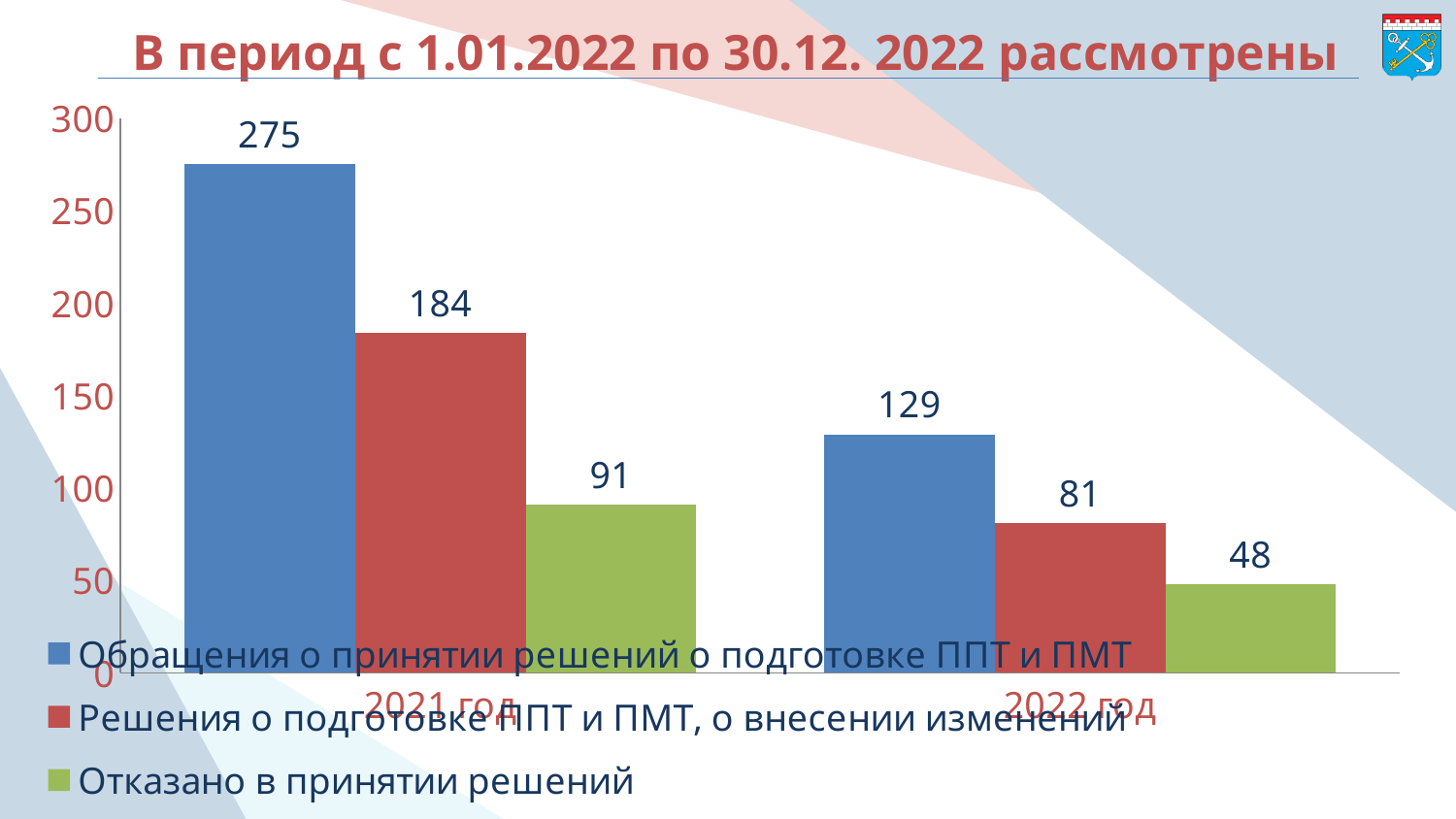
How many categories are shown on the x axis? 2 What is the value of 'Обращения о принятии решений о подготовке ППТ и ПМТ' for 2021 год? 275 Which series has the lowest value in 2022 год? Отказано в принятии решений What type of chart is shown on the slide? bar chart How many series does the legend list? 3 Do the values for 'Решения о подготовке ППТ и ПМТ, о внесении изменений' rise or fall from 2021 год to 2022 год? fall What is the difference between the 'Обращения о принятии решений о подготовке ППТ и ПМТ' values for 2021 год and 2022 год? 146 What is the value of 'Решения о подготовке ППТ и ПМТ, о внесении изменений' for 2022 год? 81 What is the value of 'Обращения о принятии решений о подготовке ППТ и ПМТ' for 2022 год? 129 Which is larger: 'Решения о подготовке ППТ и ПМТ, о внесении изменений' in 2021 год or 'Обращения о принятии решений о подготовке ППТ и ПМТ' in 2022 год? Решения о подготовке ППТ и ПМТ, о внесении изменений in 2021 год What is the value of 'Отказано в принятии решений' for 2021 год? 91 Which year has the highest value for 'Отказано в принятии решений'? 2021 год